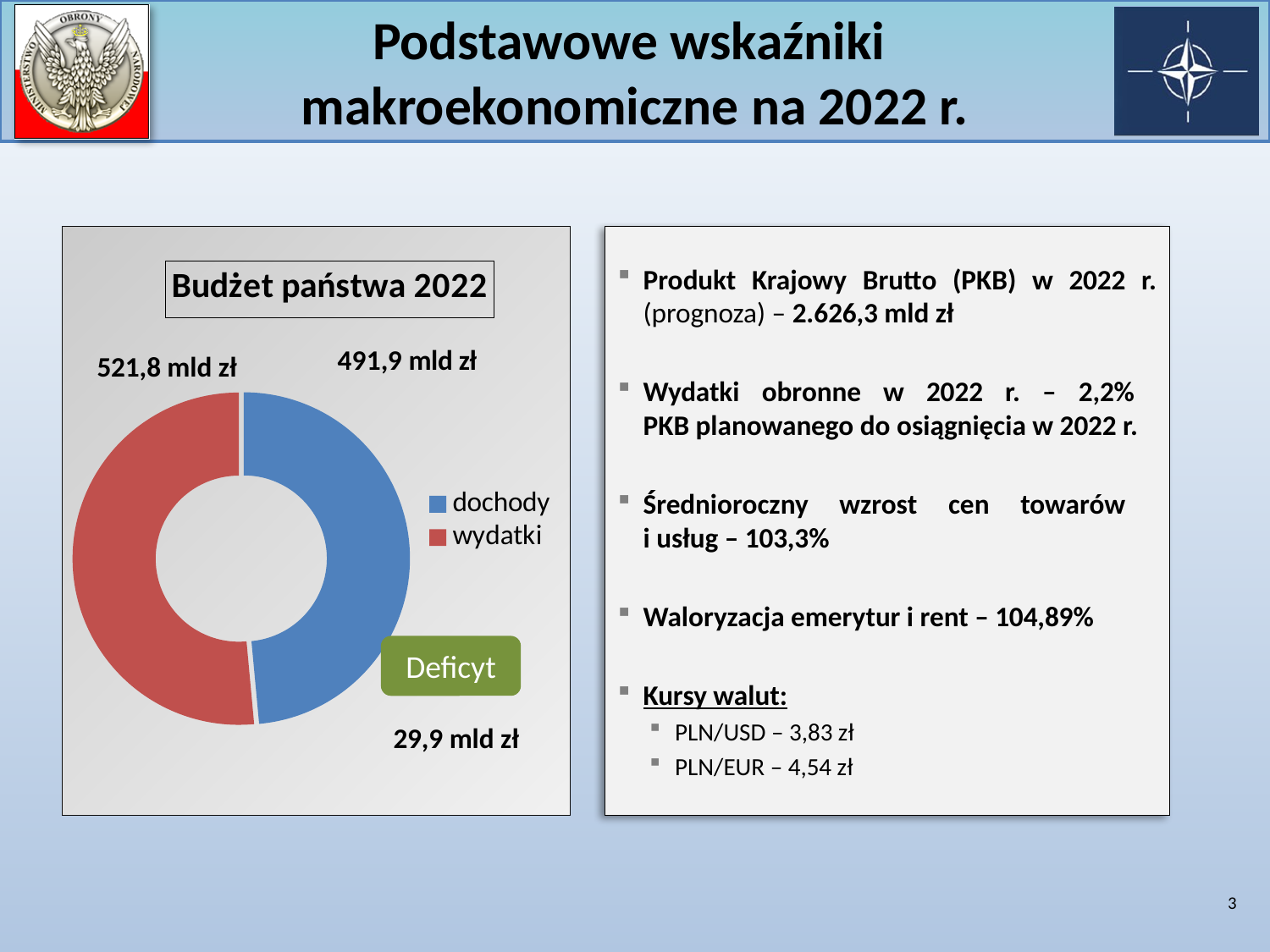
How many categories does the legend of the Budżet państwa 2022 chart list? 2 Which category has the smallest value in the Budżet państwa 2022 chart? dochody What is the value for dochody in the Budżet państwa 2022 chart? 491,9 mld zł What is the difference between wydatki and dochody in the Budżet państwa 2022 chart? 29,9 mld zł What is the value for wydatki in the Budżet państwa 2022 chart? 521,8 mld zł What is the total of dochody and wydatki in the Budżet państwa 2022 chart? 1.013,7 mld zł What colour represents wydatki in the Budżet państwa 2022 chart? red Which category has the largest value in the Budżet państwa 2022 chart? wydatki How many slices does the Budżet państwa 2022 chart have? 2 Which category is larger in the Budżet państwa 2022 chart, dochody or wydatki? wydatki What kind of chart is shown on the slide? doughnut chart What is the title of the chart on the slide? Budżet państwa 2022